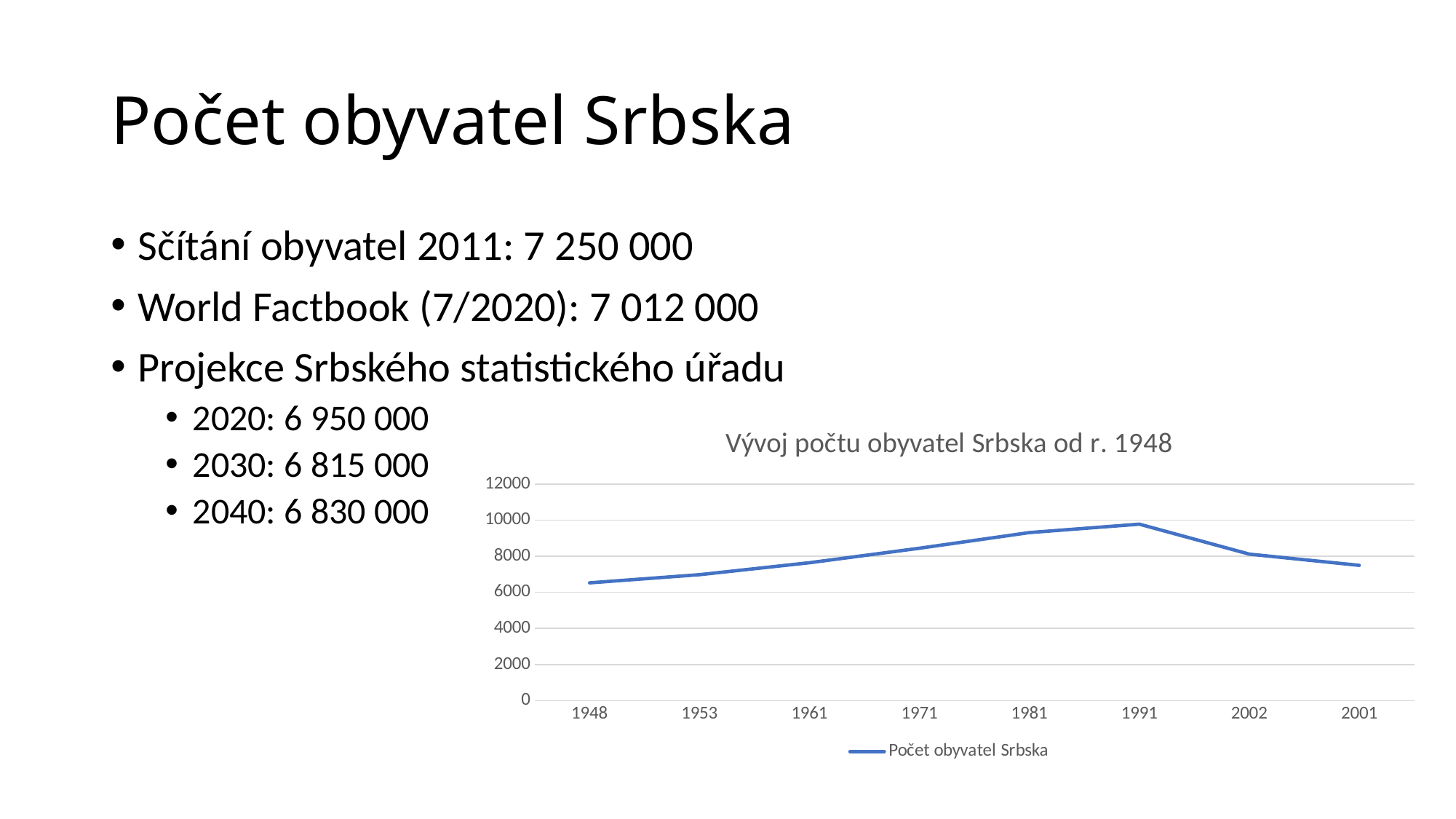
In which year is the plotted population at its lowest value? 1948 What kind of chart is shown on the slide? line chart How many years are plotted along the x axis of the chart? 8 How many series does the chart legend list? 1 In which year does the plotted population reach its highest value? 1991 Which year has the larger value, 1953 or 1981? 1981 Is the value for 1991 greater or less than 10000? less Does the plotted population rise or fall between 1948 and 1991? rise Is the value for 1948 greater or less than 8000? less What is the title of the chart? Vývoj počtu obyvatel Srbska od r. 1948 Is the value for 1991 greater or less than 8000? greater What is the name of the series shown in the chart legend? Počet obyvatel Srbska